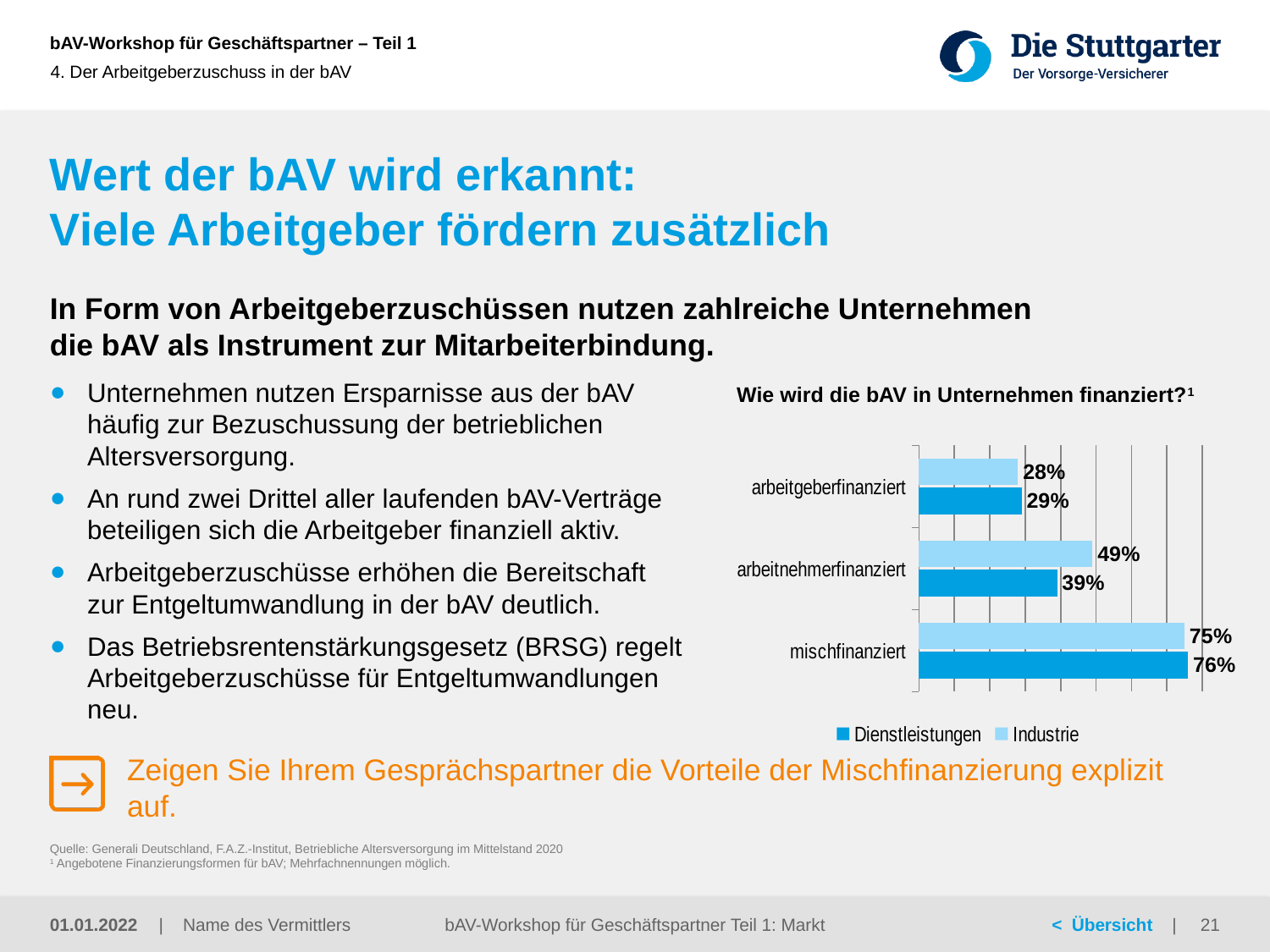
What is the value for Industrie in the category arbeitnehmerfinanziert? 49% What is the value for Dienstleistungen in the category arbeitnehmerfinanziert? 39% What is the value for Dienstleistungen in the category mischfinanziert? 76% What is the value for Industrie in the category arbeitgeberfinanziert? 28% What kind of chart is shown on the slide? Bar chart How many categories are shown on the chart? 3 Which category has the highest value for Dienstleistungen? mischfinanziert How many series does the legend list? 2 What is the difference between the Industrie and Dienstleistungen values for arbeitnehmerfinanziert? 10% Which category has the lowest value for Industrie? arbeitgeberfinanziert For arbeitnehmerfinanziert, which series has the larger value, Dienstleistungen or Industrie? Industrie What is the title of the chart? Wie wird die bAV in Unternehmen finanziert?